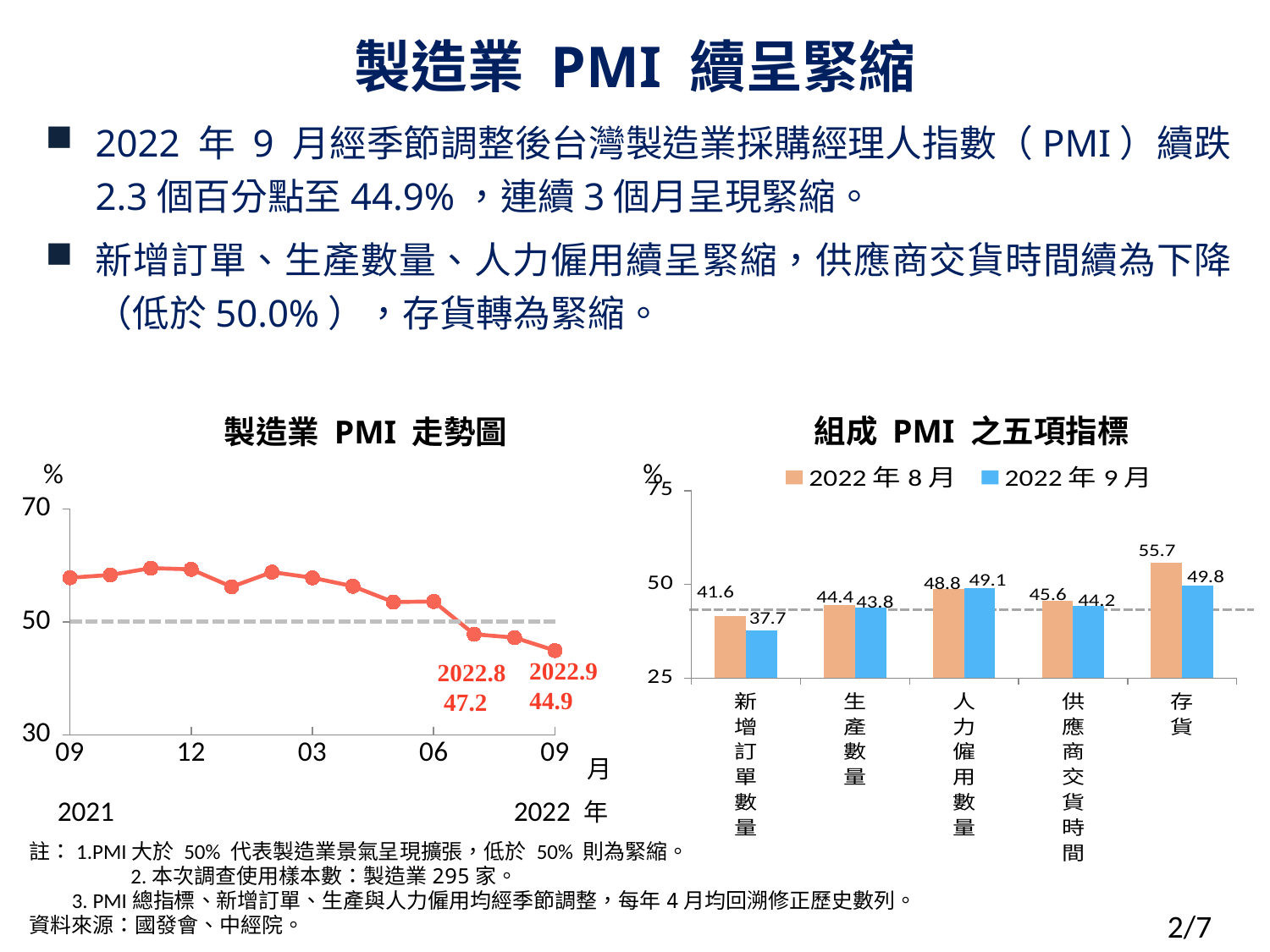
In the chart titled 組成 PMI 之五項指標, what is the value for 新增訂單數量 in 2022 年 9 月? 37.7 In the chart titled 組成 PMI 之五項指標, what is the value for 存貨 in 2022 年 8 月? 55.7 In the chart titled 製造業 PMI 走勢圖, what kind of chart is shown? line chart In the chart titled 組成 PMI 之五項指標, which category has the highest value in 2022 年 9 月? 存貨 In the chart titled 製造業 PMI 走勢圖, what is the difference between the labelled values for 2022.8 and 2022.9? 2.3 In the chart titled 製造業 PMI 走勢圖, what is the PMI value labelled for 2022.9? 44.9 In the chart titled 組成 PMI 之五項指標, which category has the lowest value in 2022 年 8 月? 新增訂單數量 In the chart titled 製造業 PMI 走勢圖, do the values generally rise or fall from 2021 09 to 2022 09? fall In the chart titled 組成 PMI 之五項指標, how many series does the legend list? 2 In the chart titled 組成 PMI 之五項指標, what is the difference between the 2022 年 8 月 and 2022 年 9 月 values for 存貨? 5.9 In the chart titled 製造業 PMI 走勢圖, what is the PMI value labelled for 2022.8? 47.2 In the chart titled 組成 PMI 之五項指標, is the 2022 年 9 月 value for 人力僱用數量 larger or smaller than its 2022 年 8 月 value? larger